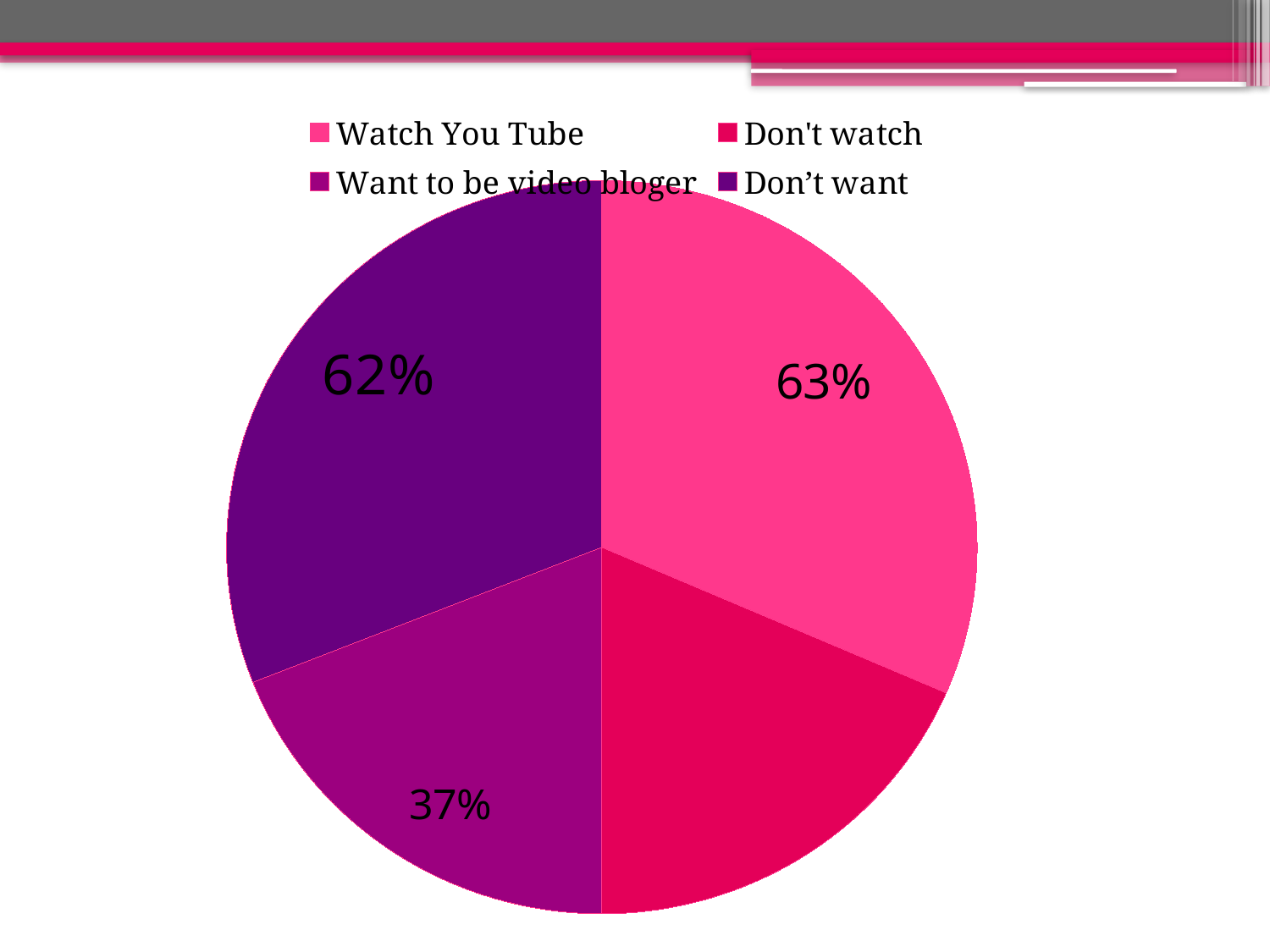
Which is larger, the Watch You Tube slice or the Don't watch slice? Watch You Tube What is the difference between the Watch You Tube value and the Want to be video bloger value? 26% Which legend entry is shown in the darkest purple colour? Don't want How many entries does the legend list? 4 What percentage is shown for the Don't want slice? 62% What kind of chart is shown on the slide? Pie chart Which slice of the pie chart has no percentage label printed on it? Don't watch How many slices does the pie chart have? 4 What is the difference between the Watch You Tube value and the Don't want value? 1% What percentage is shown for the Want to be video bloger slice? 37% Which is larger, the Watch You Tube slice or the Want to be video bloger slice? Watch You Tube What percentage is shown for the Watch You Tube slice? 63%